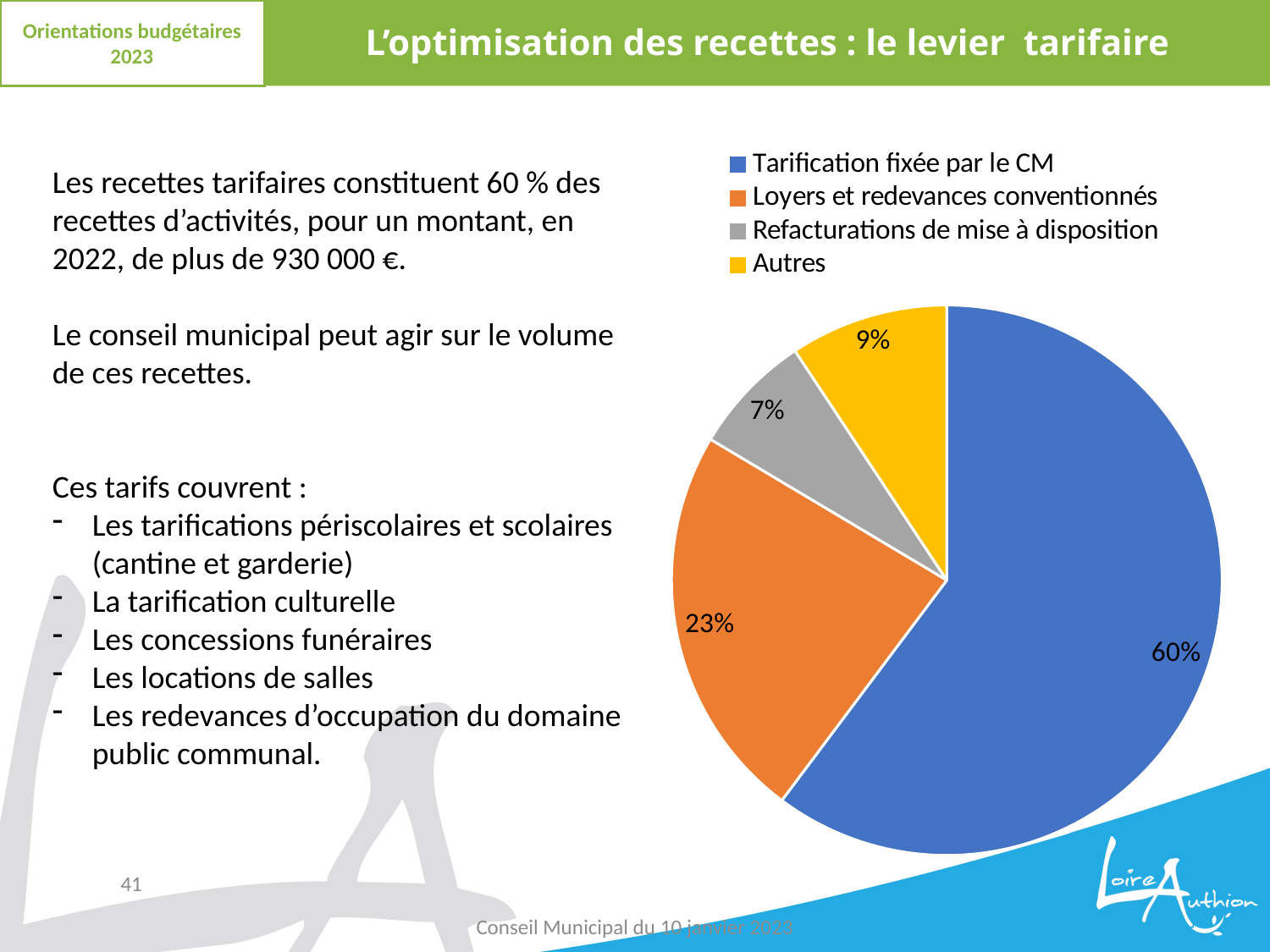
What colour is the slice for "Loyers et redevances conventionnés"? orange What share of the pie does "Refacturations de mise à disposition" represent? 7% Which category has the smallest slice of the pie? Refacturations de mise à disposition What share of the pie does "Loyers et redevances conventionnés" represent? 23% Which category has the largest slice of the pie? Tarification fixée par le CM What share of the pie does "Tarification fixée par le CM" represent? 60% How many categories does the pie chart show? 4 What kind of chart is shown on the slide? pie chart Which is larger: the slice for "Autres" or the slice for "Refacturations de mise à disposition"? Autres What colour is the slice for "Autres"? yellow What is the difference in percentage points between "Tarification fixée par le CM" and "Loyers et redevances conventionnés"? 37 percentage points